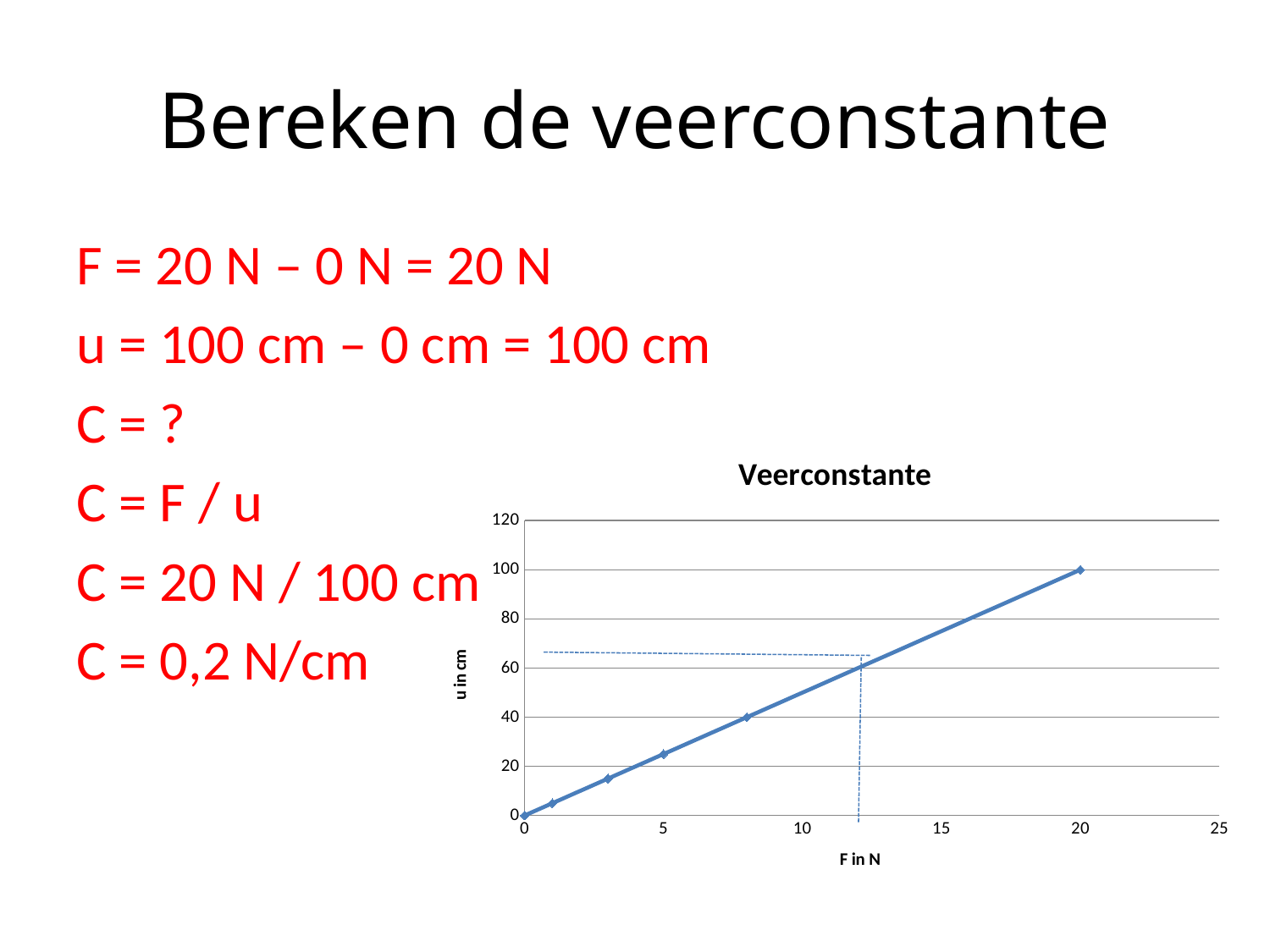
Is the value of u at F = 15 N greater or less than 60? greater What is the value of u in cm at F = 0 N in the chart? 0 Which is larger: u at F = 8 N or u at F = 3 N? u at F = 8 N What is the value of u in cm at F = 20 N in the chart? 100 Does u in cm rise or fall as F in N increases along the x axis? rise What kind of chart is shown on the slide? line chart What is the title of the chart? Veerconstante How many data points are plotted in the chart? 6 What is the label of the x axis of the chart? F in N What is the highest value shown on the y axis of the chart? 120 At which value of F in N is the plotted u in cm highest? 20 Is the value of u at F = 5 N greater or less than 40? less